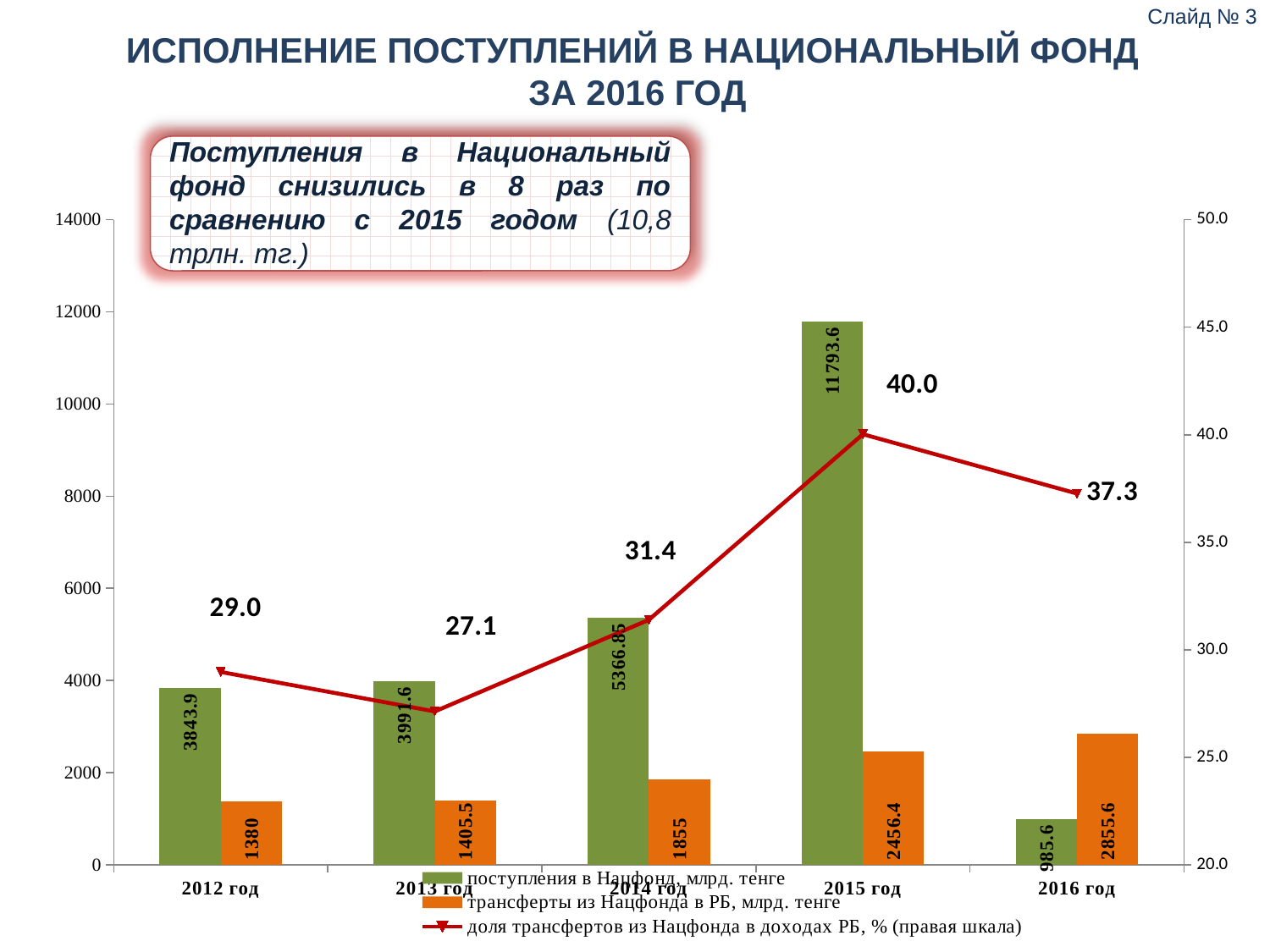
In which year is the доля трансфертов из Нацфонда в доходах РБ the lowest? 2013 год Which is larger in 2016 год: поступления в Нацфонд or трансферты из Нацфонда в РБ? трансферты из Нацфонда в РБ How many series does the legend list? 3 Is the value of поступления в Нацфонд for 2014 год greater or less than 4000? greater How many years are shown on the x axis? 5 What is the value of трансферты из Нацфонда в РБ for 2016 год? 2855.6 What is the доля трансфертов из Нацфонда в доходах РБ for 2014 год? 31.4 What is the value of поступления в Нацфонд for 2015 год? 11793.6 In which year is поступления в Нацфонд the lowest? 2016 год Do the values of трансферты из Нацфонда в РБ rise or fall from 2012 год to 2016 год? rise In which year is поступления в Нацфонд the highest? 2015 год What is the difference between трансферты из Нацфонда в РБ in 2016 год and in 2015 год? 399.2